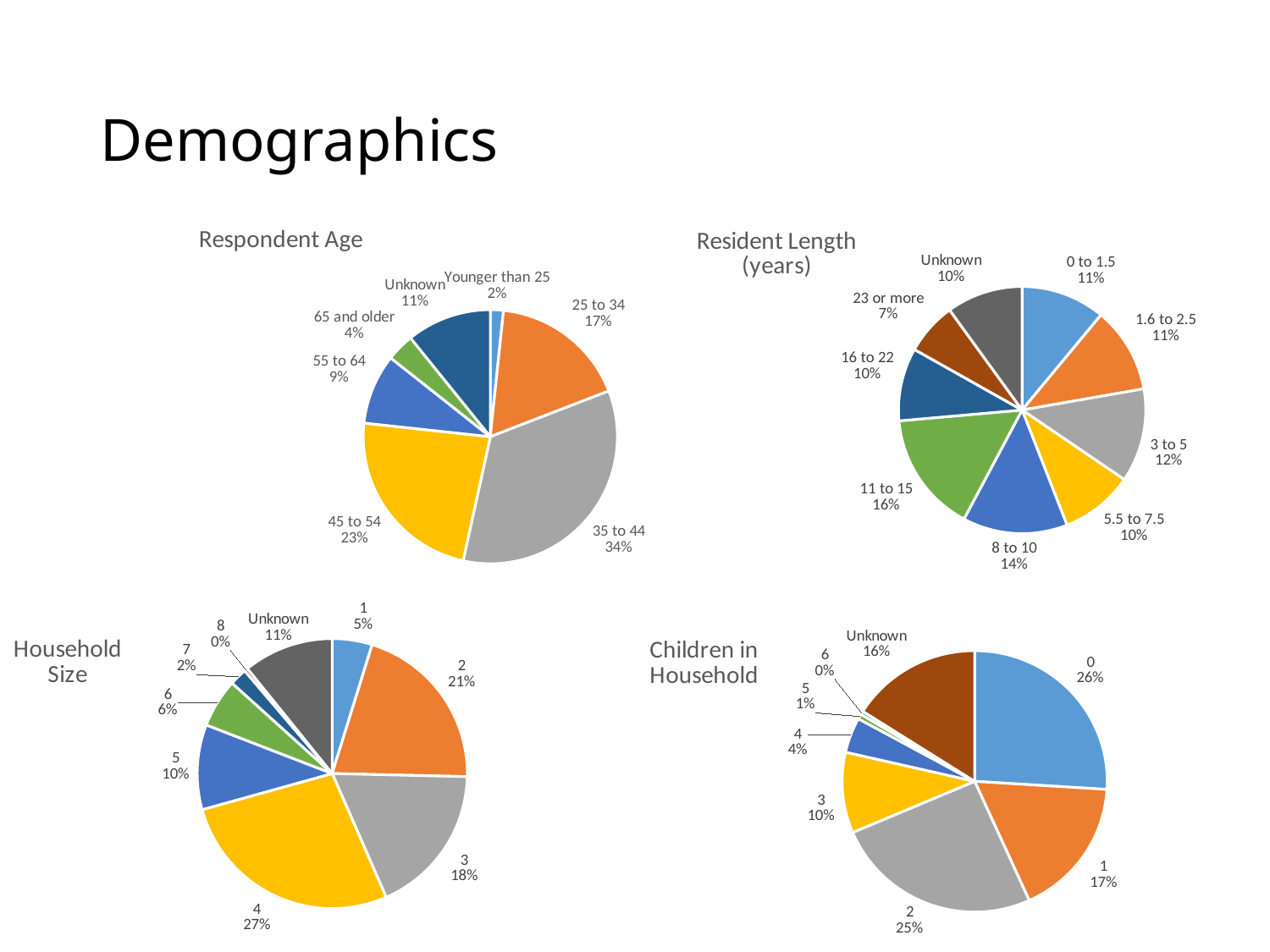
In the Respondent Age chart, which age group has the smallest share? Younger than 25 In the Children in Household chart, what share of households have 0 children? 26% In the Household Size chart, which is larger, the share for 2 or the share for 3? 2 In the Children in Household chart, what is the difference between the share for 2 children and the share for 1 child? 8% In the Respondent Age chart, which age group has the largest share? 35 to 44 In the Household Size chart, what share of households have 4 members? 27% In the Resident Length (years) chart, what share of residents have lived there 11 to 15 years? 16% What type of chart is used for Children in Household? Pie chart In the Respondent Age chart, what is the difference between the 45 to 54 share and the 25 to 34 share? 6% How many categories does the Resident Length (years) pie chart show? 9 In the Resident Length (years) chart, which category has the smallest share? 23 or more